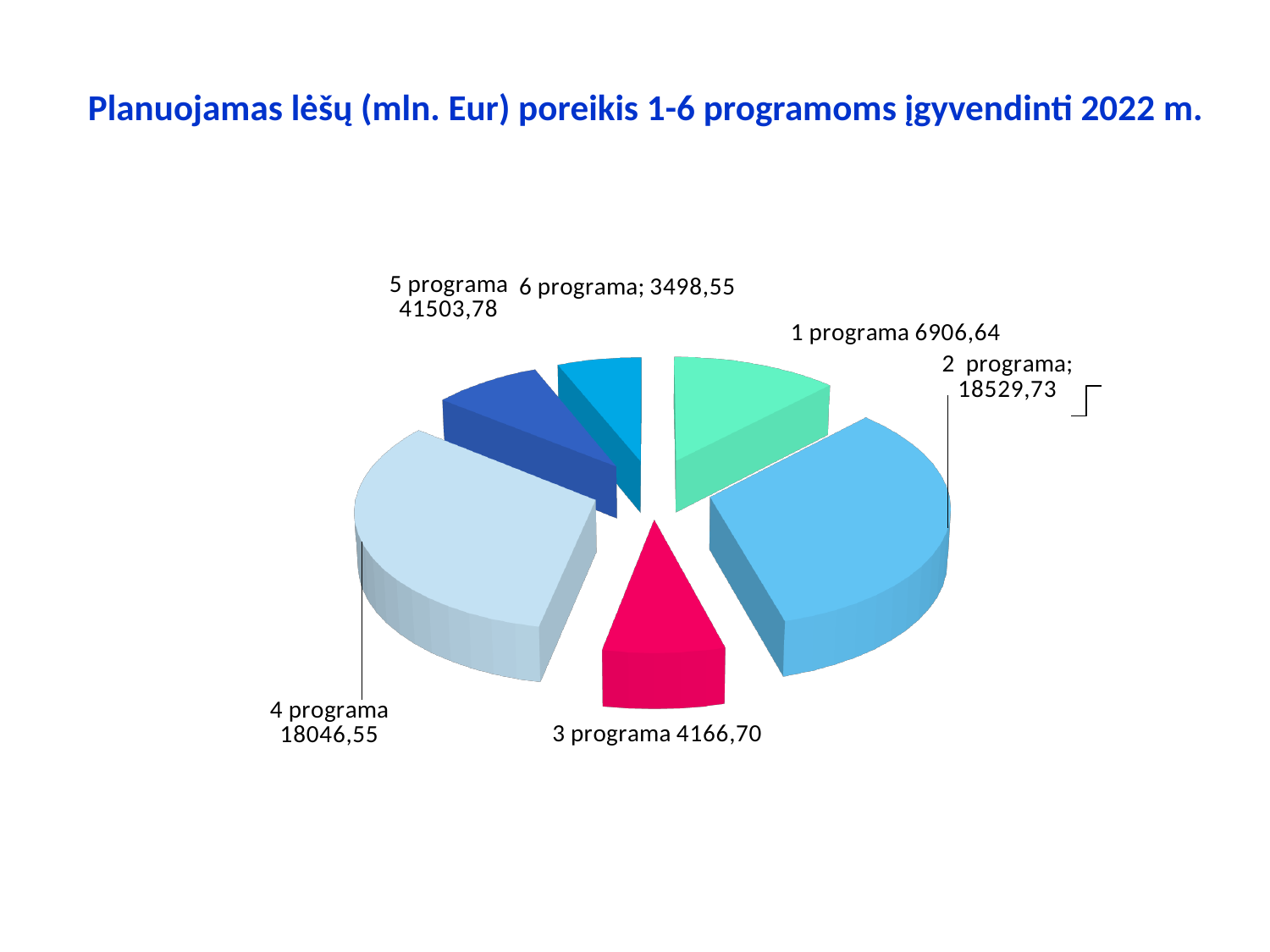
What is the value shown for 3 programa? 4166,70 In what unit are the values in the chart expressed, according to the slide title? mln. Eur What is the difference between the values for 2 programa and 4 programa? 483,18 What kind of chart is shown on the slide? Pie chart What is the value shown for 2 programa? 18529,73 What is the value shown for 1 programa? 6906,64 Which programa has the lowest value according to the data labels? 6 programa Which is larger, the value for 2 programa or the value for 1 programa? 2 programa How many slices does the pie chart have? 6 What is the value shown for 4 programa? 18046,55 What is the value shown for 6 programa? 3498,55 What is the value shown for 5 programa? 41503,78